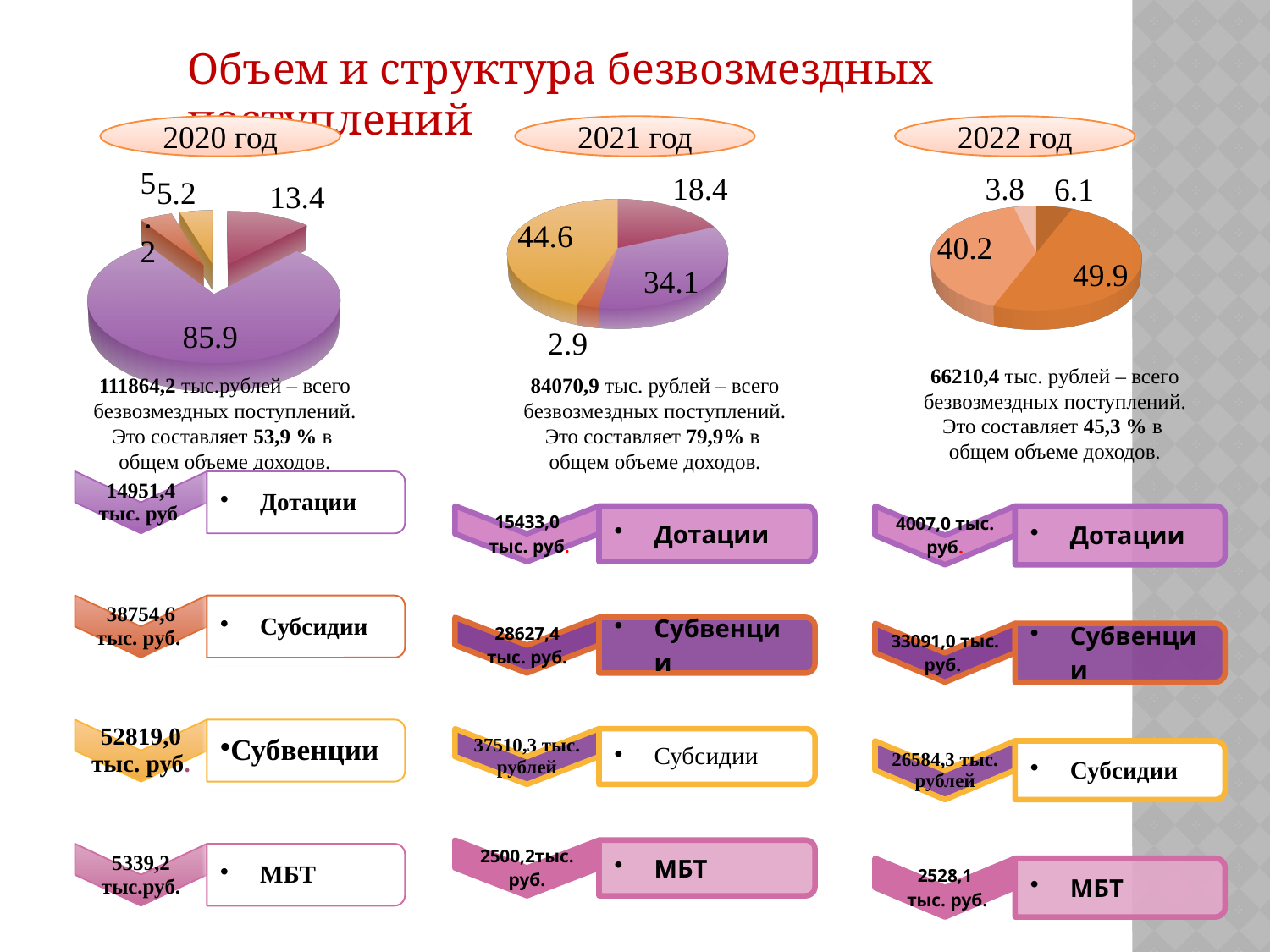
How many slices does the 2021 год pie chart have? 4 What kind of chart is used for the 2021 год data? pie chart On the 2022 год pie chart, which is larger: the slice labelled 6.1 or the slice labelled 3.8? 6.1 On the 2021 год pie chart, what is the difference between the largest slice (44.6) and the slice labelled 34.1? 10.5 How many slices does the 2022 год pie chart have? 4 On the 2021 год pie chart, what is the smallest value shown? 2.9 On the 2022 год pie chart, what is the smallest value shown? 3.8 On the 2022 год pie chart, what is the largest value shown? 49.9 How many pie charts are shown on the slide? 3 On the 2022 год pie chart, what is the difference between the slices labelled 49.9 and 40.2? 9.7 On the 2020 год pie chart, what is the largest value shown? 85.9 On the 2021 год pie chart, what is the largest value shown? 44.6